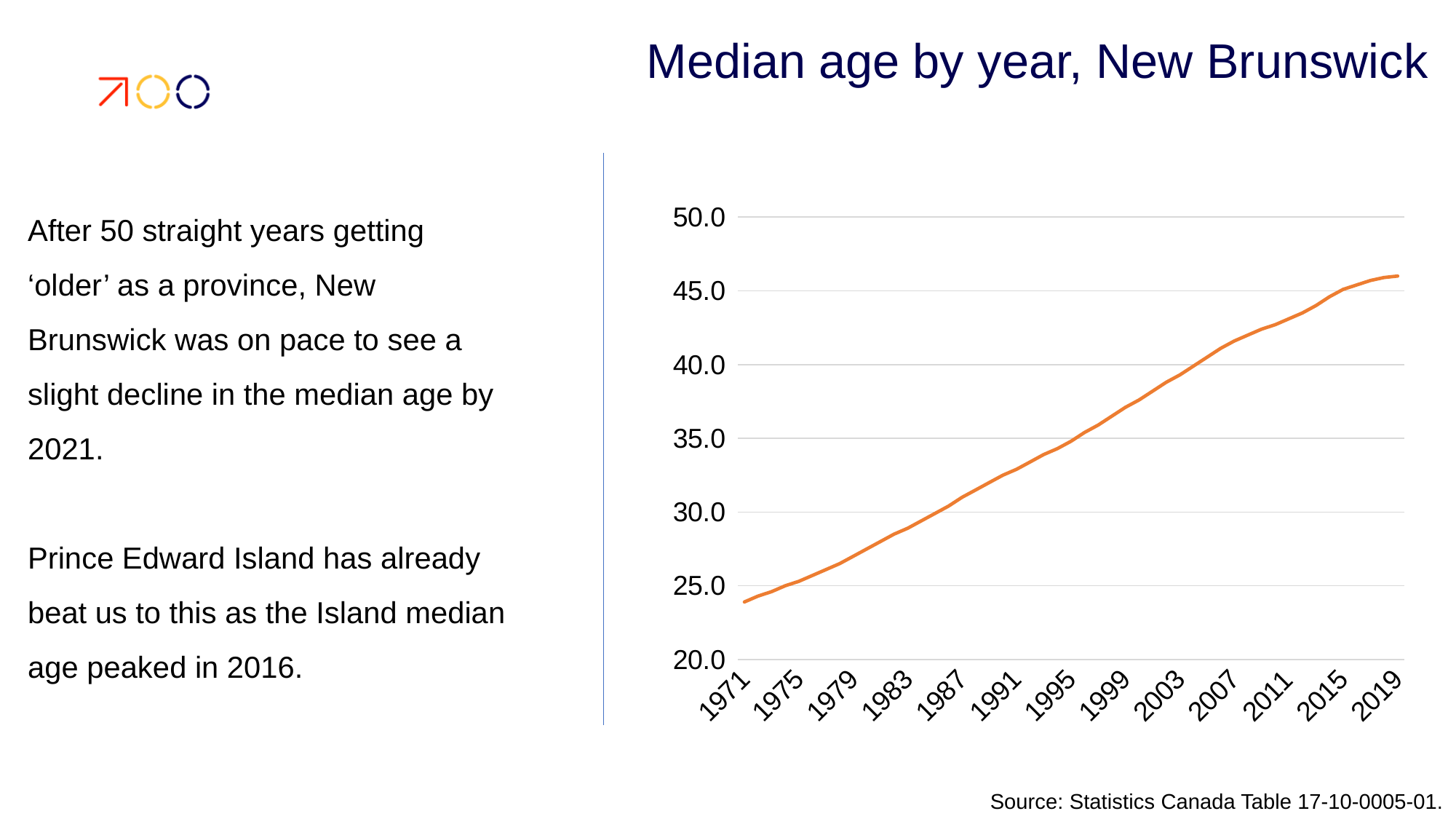
Is the median age for 1971 greater or less than 25.0? less Which year has a higher median age, 1983 or 2003? 2003 Is the median age for 2007 greater or less than 40.0? greater What kind of chart is shown on the slide? line chart What is the title of the chart? Median age by year, New Brunswick Is the median age for 1999 greater or less than 35.0? greater Does the median age rise or fall from 1971 to 2019? rise Which year shown on the x axis has the highest median age? 2019 Which year shown on the x axis has the lowest median age? 1971 How many year labels are shown on the x axis? 13